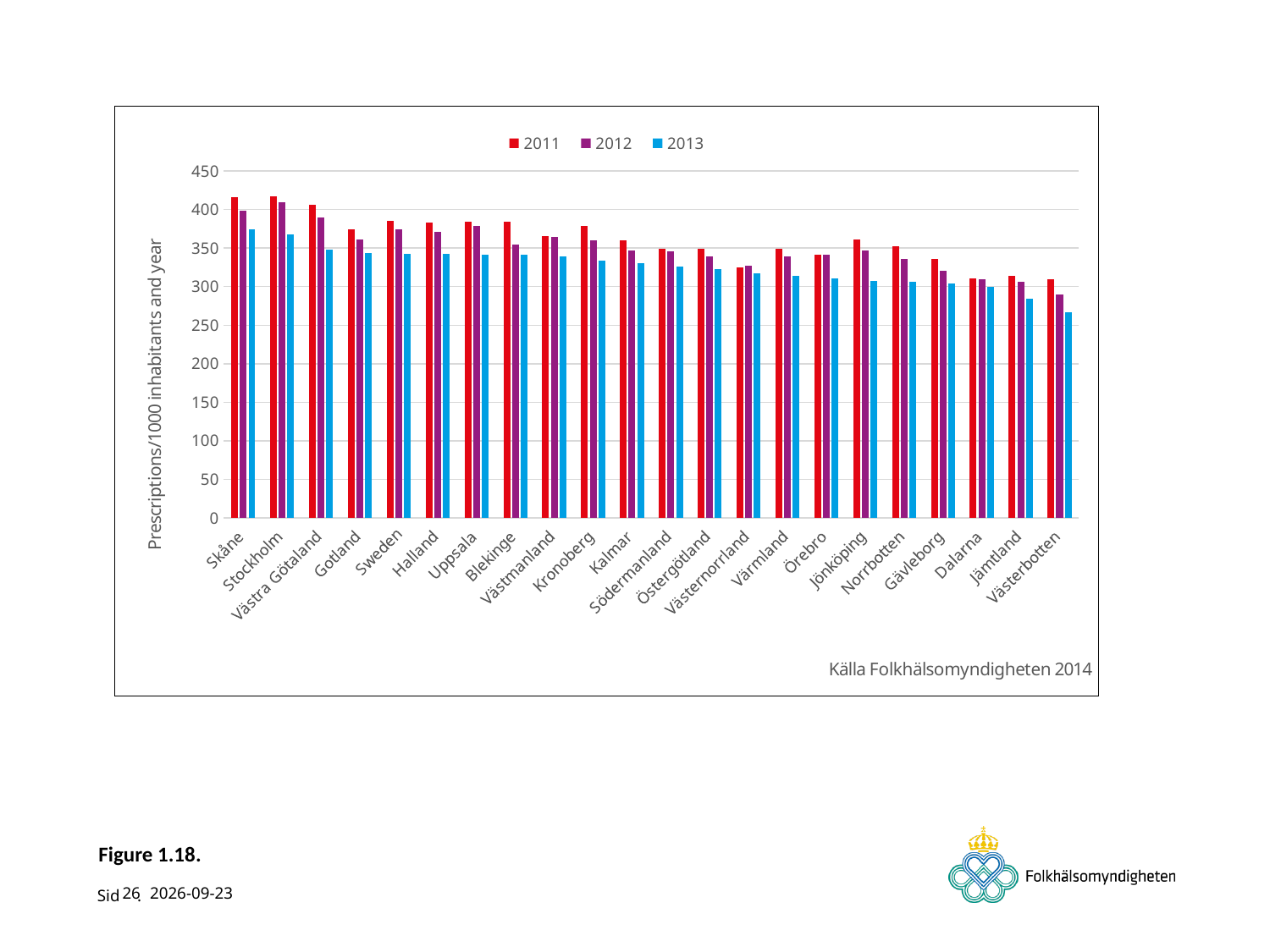
How many categories are shown along the x axis? 22 How many series does the legend list? 3 Which is larger, the 2011 value for Stockholm or the 2011 value for Gävleborg? Stockholm Which category has the lowest value for 2012? Västerbotten What kind of chart is shown on the slide? bar chart Is the 2011 value for Skåne greater or less than 400? greater Which category has the lowest value for 2013? Västerbotten What is the label on the y axis? Prescriptions/1000 inhabitants and year Is the 2013 value for Västerbotten greater or less than 300? less Is the 2013 value for Stockholm greater or less than 350? greater Do the 2011 values generally rise or fall moving from left to right along the x axis? fall